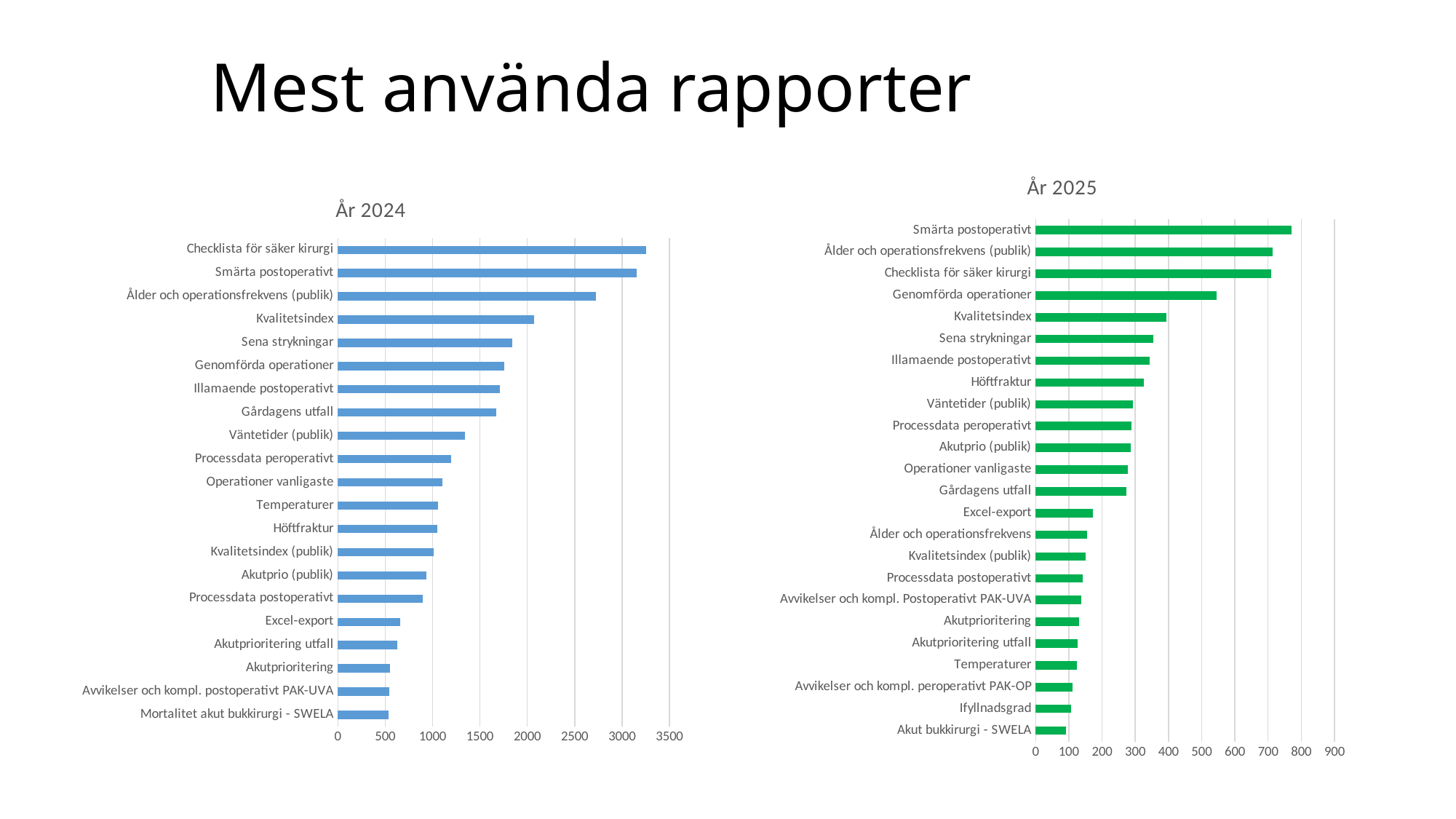
In the "År 2024" chart, is the value for Väntetider (publik) greater or less than 1500? less How many reports are listed in the "År 2024" chart? 21 In the "År 2025" chart, is the value for Genomförda operationer greater or less than 500? greater What colour are the bars in the "År 2025" chart? green How many reports are listed in the "År 2025" chart? 24 In the "År 2024" chart, which report has the highest value? Checklista för säker kirurgi In the "År 2024" chart, which is larger: Kvalitetsindex or Sena strykningar? Kvalitetsindex In the "År 2025" chart, which report has the lowest value? Akut bukkirurgi - SWELA What kind of chart is the "År 2024" chart? bar chart In the "År 2025" chart, is the value for Excel-export greater or less than 100? greater In the "År 2025" chart, which report has the highest value? Smärta postoperativt